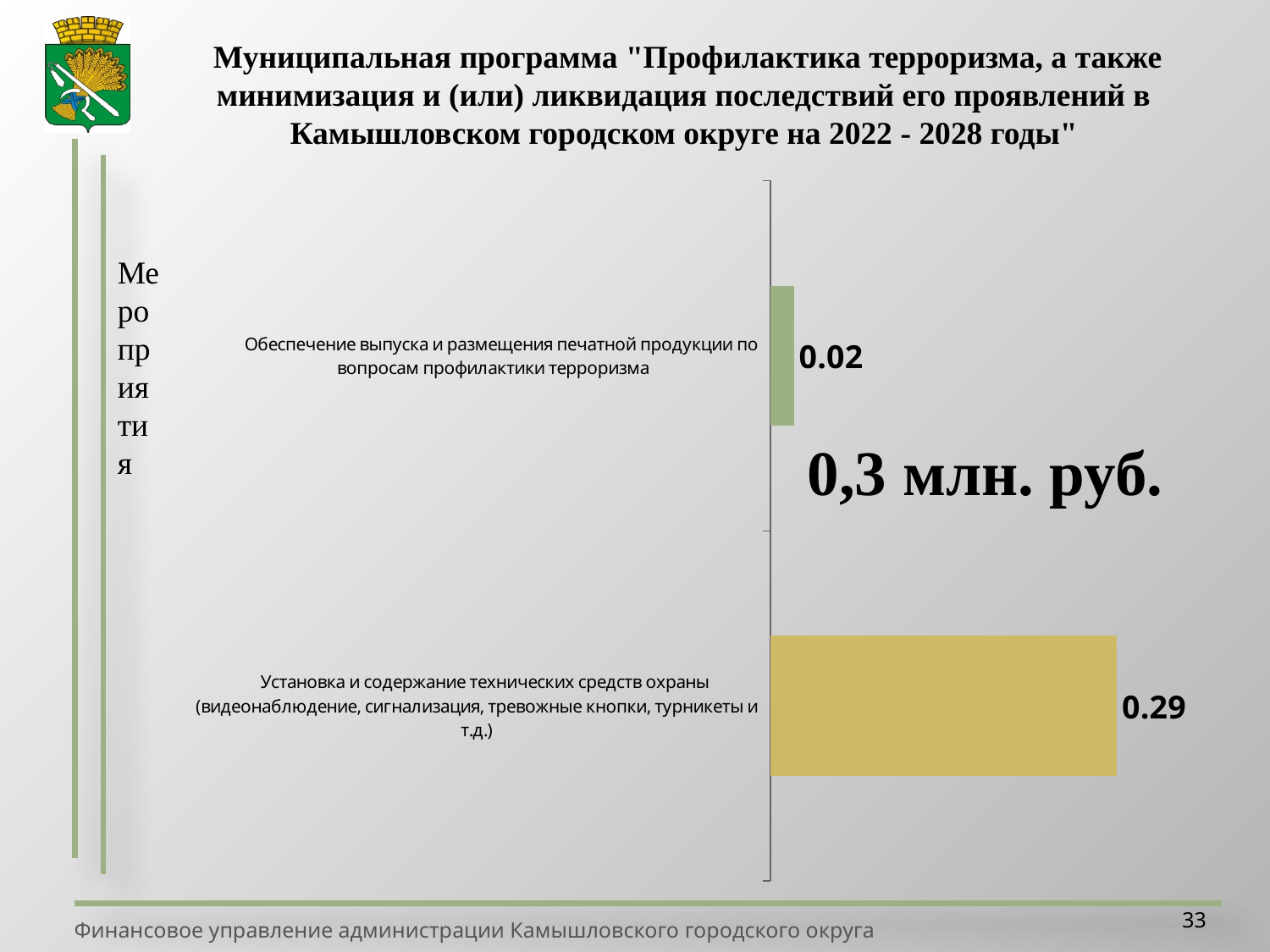
What is the difference between the value for "Установка и содержание технических средств охраны" and the value for "Обеспечение выпуска и размещения печатной продукции"? 0.27 What kind of chart is shown on the slide? Bar chart What is the value for "Обеспечение выпуска и размещения печатной продукции по вопросам профилактики терроризма"? 0.02 What is the value for "Установка и содержание технических средств охраны (видеонаблюдение, сигнализация, тревожные кнопки, турникеты и т.д.)"? 0.29 How many categories are shown in the chart? 2 What is the label on the vertical axis of the chart? Мероприятия What total amount is printed next to the chart? 0,3 млн. руб. Which is larger: the value for "Обеспечение выпуска и размещения печатной продукции" or the value for "Установка и содержание технических средств охраны"? Установка и содержание технических средств охраны Which category has the highest value? Установка и содержание технических средств охраны (видеонаблюдение, сигнализация, тревожные кнопки, турникеты и т.д.) Which category has the lowest value? Обеспечение выпуска и размещения печатной продукции по вопросам профилактики терроризма